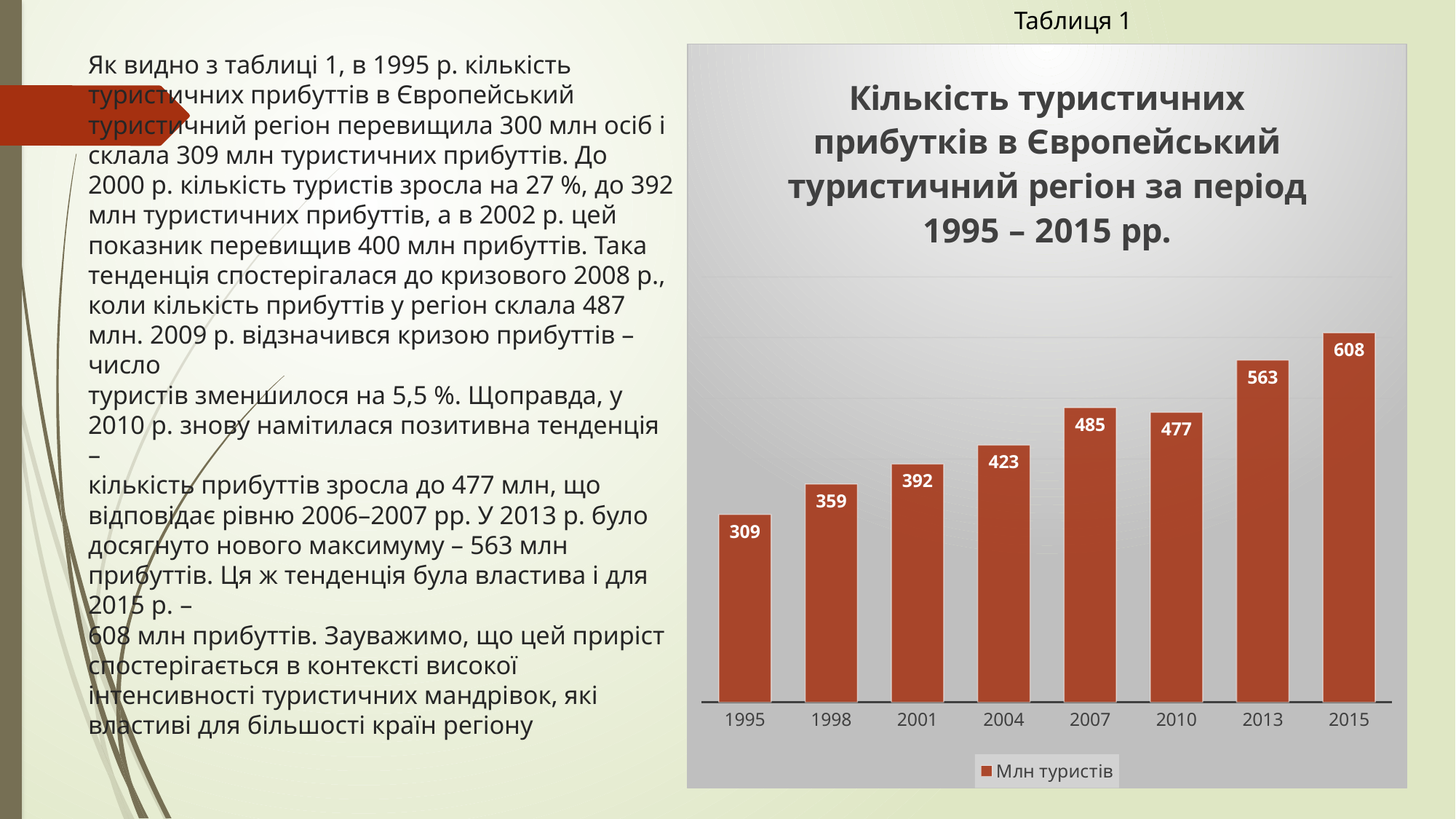
What is the value for 2013? 563 What is the value for 2007? 485 How many years are shown on the x axis? 8 Which year has the highest value? 2015 How many series does the legend list? 1 Which year has the lowest value? 1995 What is the difference between the values for 2015 and 1995? 299 What is the legend entry of the chart? Млн туристів Which is larger, the value for 2001 or the value for 2004? 2004 What kind of chart is shown? bar chart What is the value for 1995? 309 What is the difference between the values for 2007 and 2010? 8